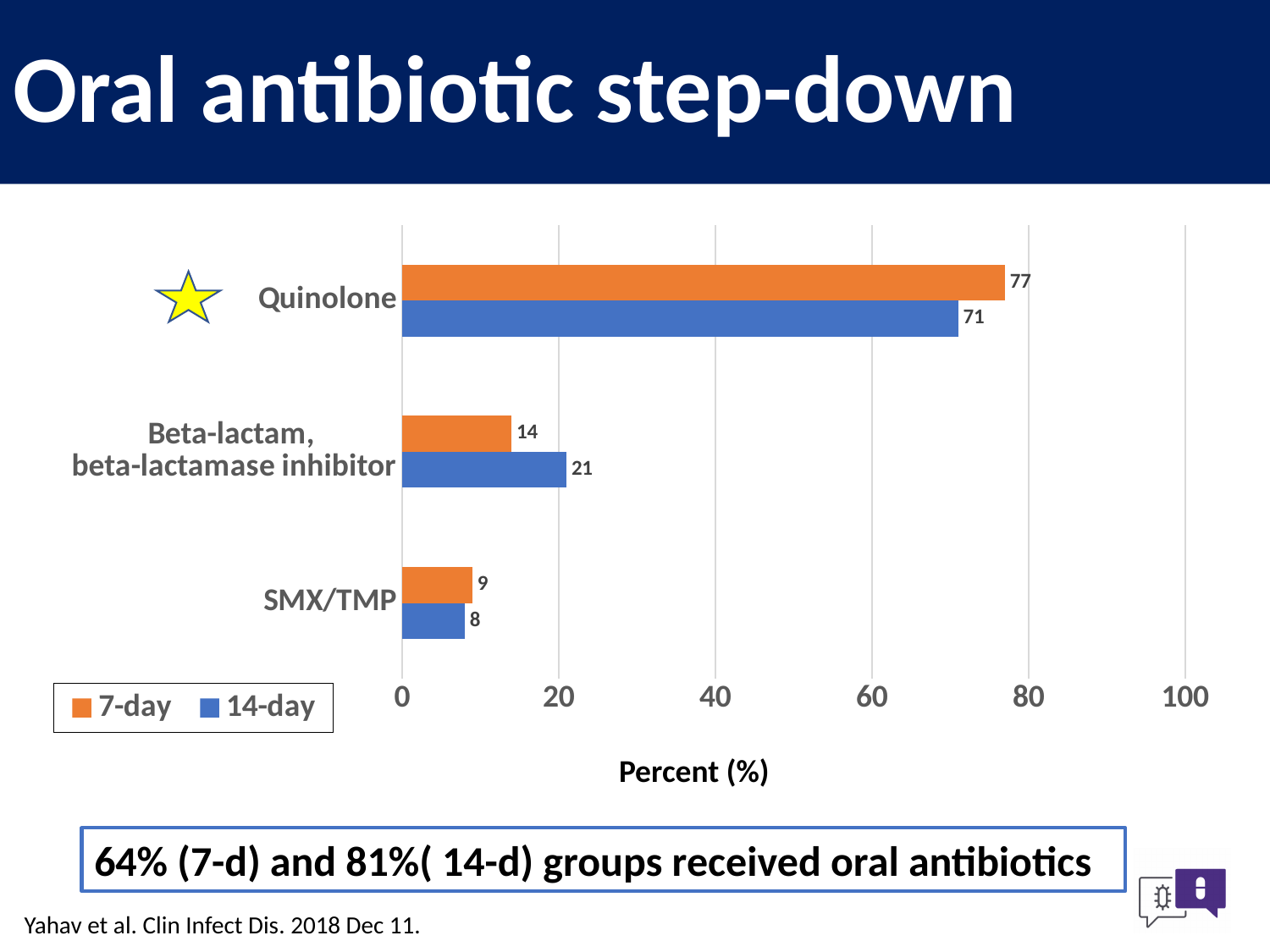
How many categories are shown on the chart? 3 Which category has the highest 14-day value? Quinolone What is the 14-day value for Beta-lactam, beta-lactamase inhibitor? 21 What is the difference between the 7-day and 14-day values for Quinolone? 6 Which category has the lowest 7-day value? SMX/TMP For Beta-lactam, beta-lactamase inhibitor, which is larger: the 7-day value or the 14-day value? 14-day What kind of chart is shown on the slide? bar chart Is the 14-day value for Quinolone greater or less than 60? greater What is the label of the x axis? Percent (%) What is the 7-day value for Quinolone? 77 What is the 14-day value for SMX/TMP? 8 How many series does the legend list? 2